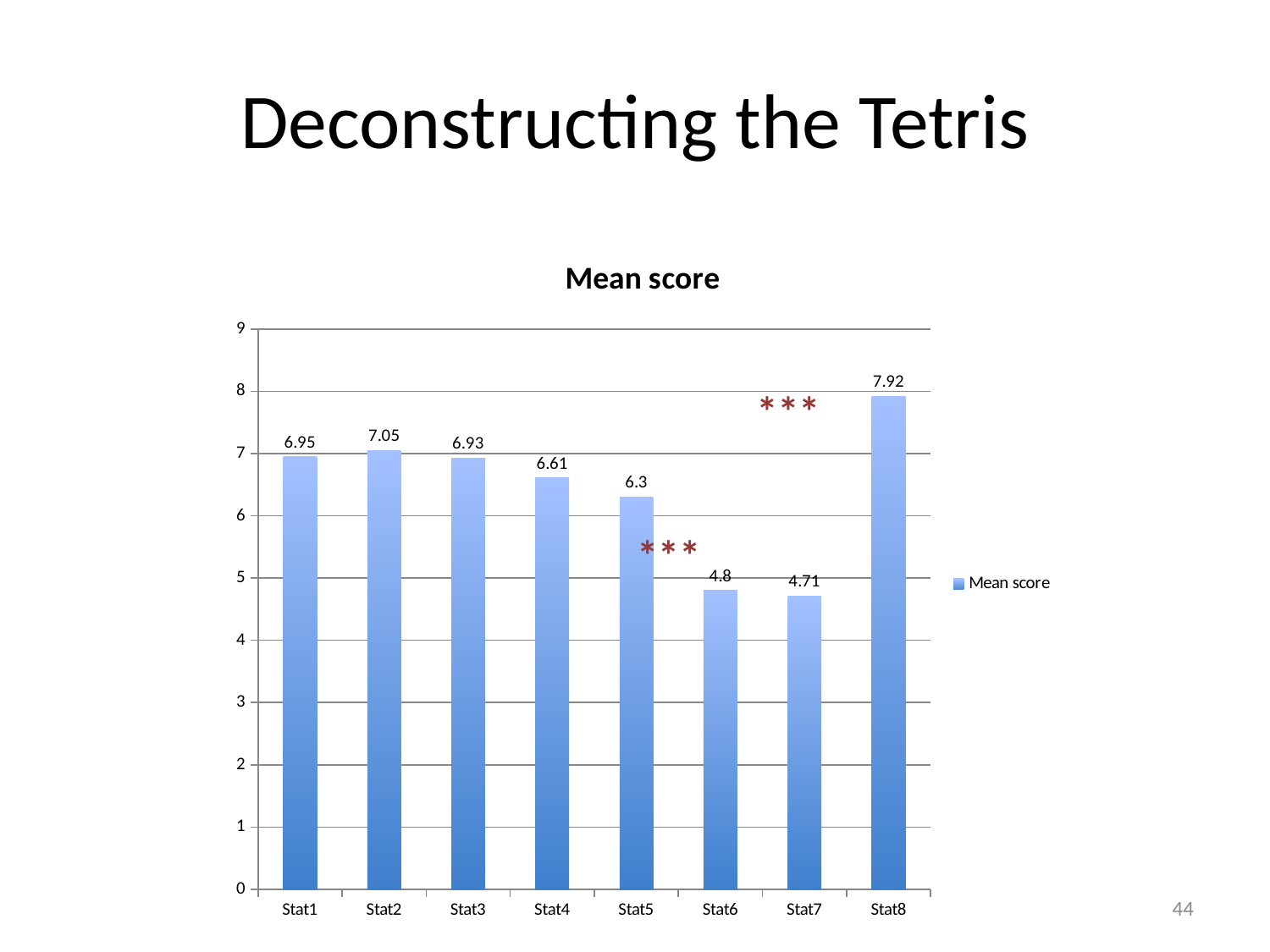
What kind of chart is shown on the slide? Bar chart What is the mean score for Stat2? 7.05 Which category has the lowest mean score? Stat7 Which category has the highest mean score? Stat8 Is the value for Stat6 greater or less than 5? less How many categories are shown on the x axis? 8 What is the mean score for Stat7? 4.71 What is the mean score for Stat4? 6.61 What is the difference between the mean scores of Stat1 and Stat5? 0.65 What is the title of the chart? Mean score What is the difference between the mean scores of Stat8 and Stat7? 3.21 Which has a higher mean score, Stat3 or Stat6? Stat3